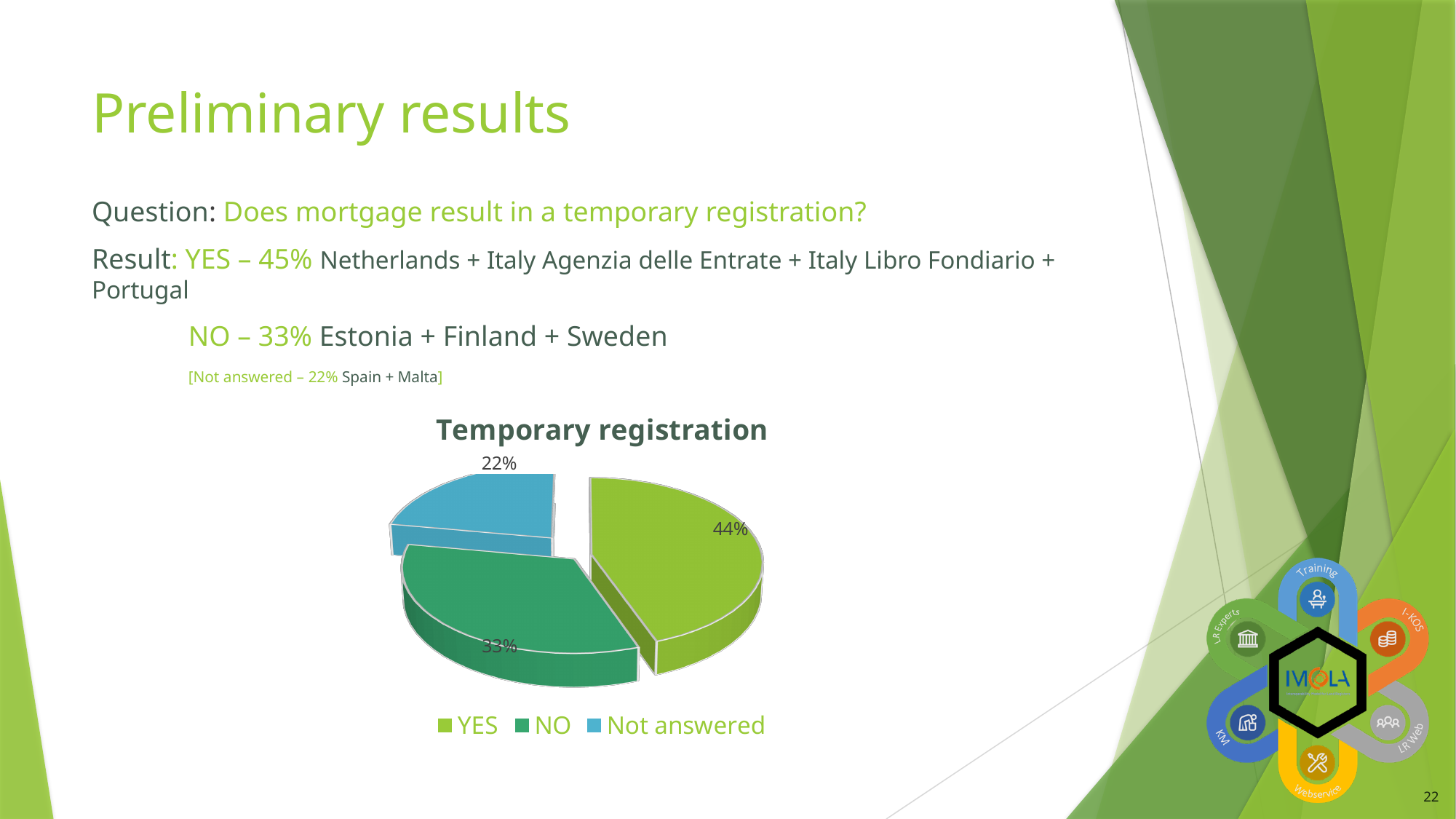
What percentage does the NO slice show in the chart? 33% What percentage does the Not answered slice show in the chart? 22% Which slice of the pie chart is the smallest? Not answered What is the difference in percentage points between the YES slice and the NO slice? 11 Which slice of the pie chart is the largest? YES Which legend entry is shown in blue in the chart? Not answered How many entries does the chart legend list? 3 What is the title of the chart? Temporary registration What percentage does the YES slice show in the chart? 44% Which is larger in the chart, the NO slice or the Not answered slice? NO How many slices does the pie chart have? 3 What kind of chart is shown on the slide? pie chart